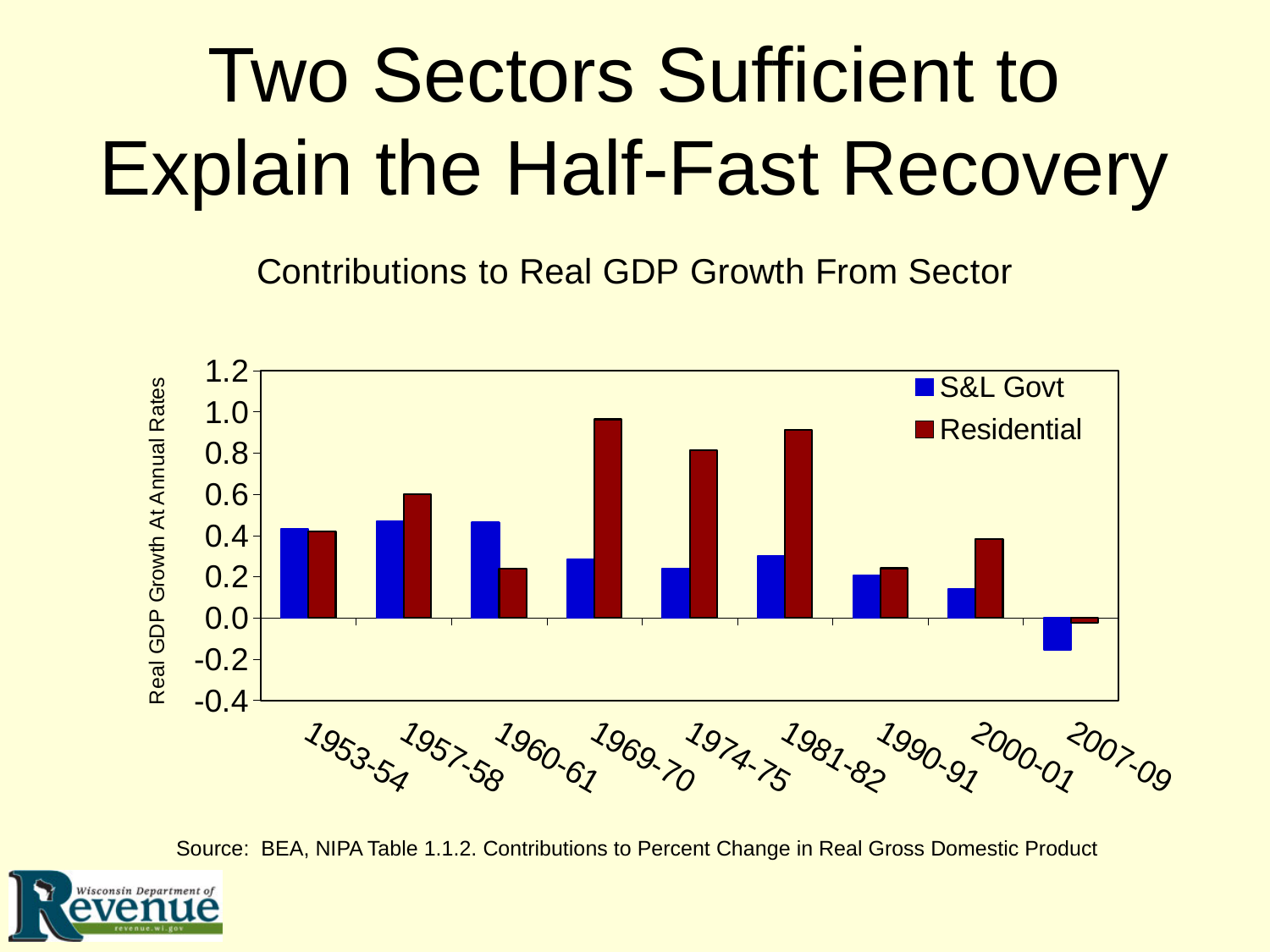
How many recovery periods are shown along the x axis? 9 What kind of chart is shown on the slide? bar chart For 1969-70, which is larger, the S&L Govt contribution or the Residential contribution? Residential For 1960-61, which is larger, the S&L Govt contribution or the Residential contribution? S&L Govt What is the title of the y axis? Real GDP Growth At Annual Rates Is the Residential value for 1957-58 greater or less than 0.4? greater Which period has the lowest Residential contribution? 2007-09 How many series does the legend list? 2 Is the Residential value for 1960-61 greater or less than 0.4? less Which period has the lowest S&L Govt contribution? 2007-09 Is the S&L Govt value for 2007-09 greater or less than 0.0? less